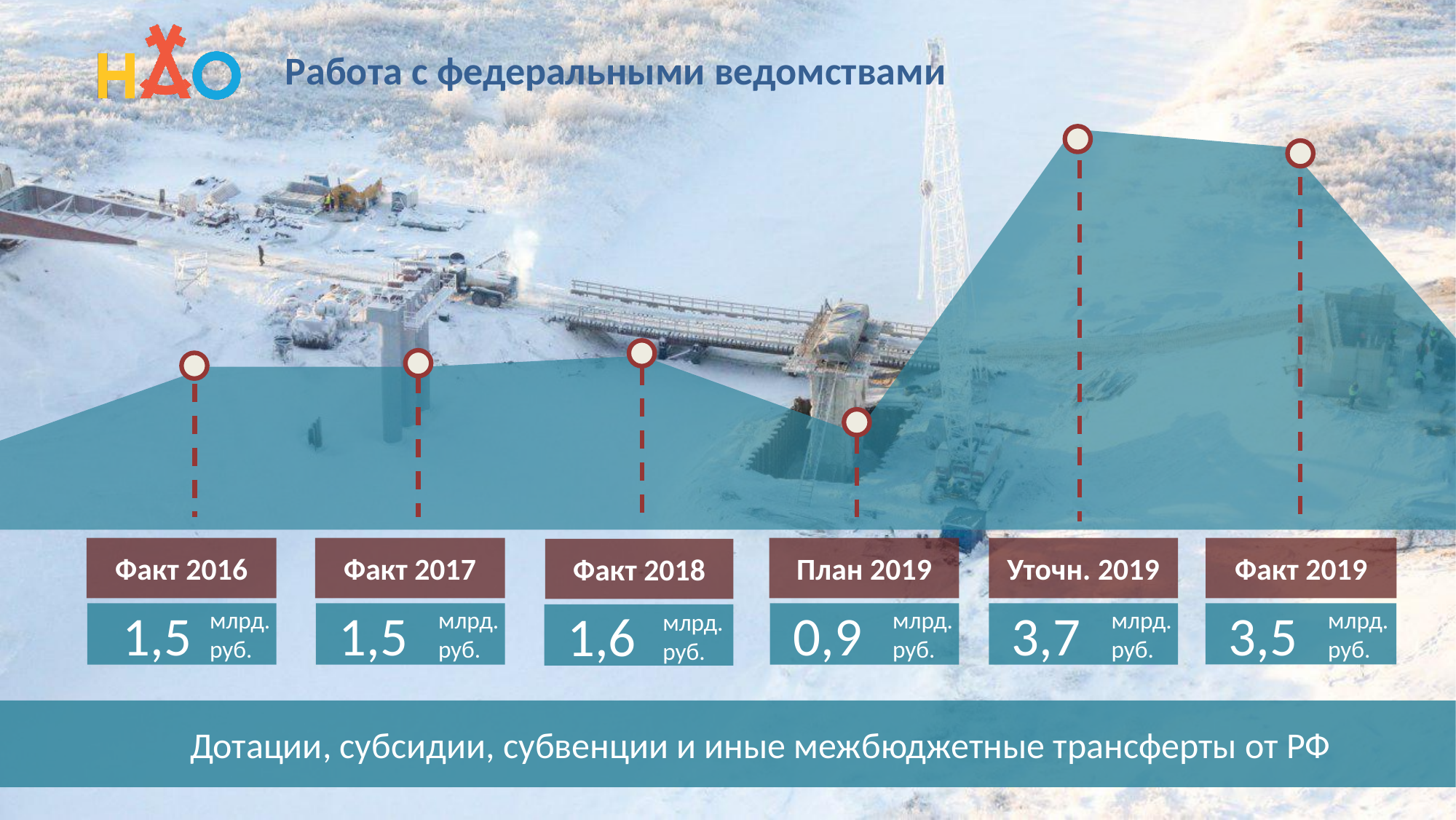
What is the value for План 2019? 0,9 млрд. руб. What is the difference between Уточн. 2019 and План 2019? 2,8 млрд. руб. What is the value for Факт 2016? 1,5 млрд. руб. What kind of chart is shown on the slide? Area chart What is the difference between Факт 2019 and Факт 2018? 1,9 млрд. руб. What is the value for Уточн. 2019? 3,7 млрд. руб. Which is larger, Факт 2019 or Уточн. 2019? Уточн. 2019 What is the value for Факт 2018? 1,6 млрд. руб. Which category has the highest value? Уточн. 2019 What is the title of the slide? Работа с федеральными ведомствами Which category has the lowest value? План 2019 How many data points are shown on the chart? 6